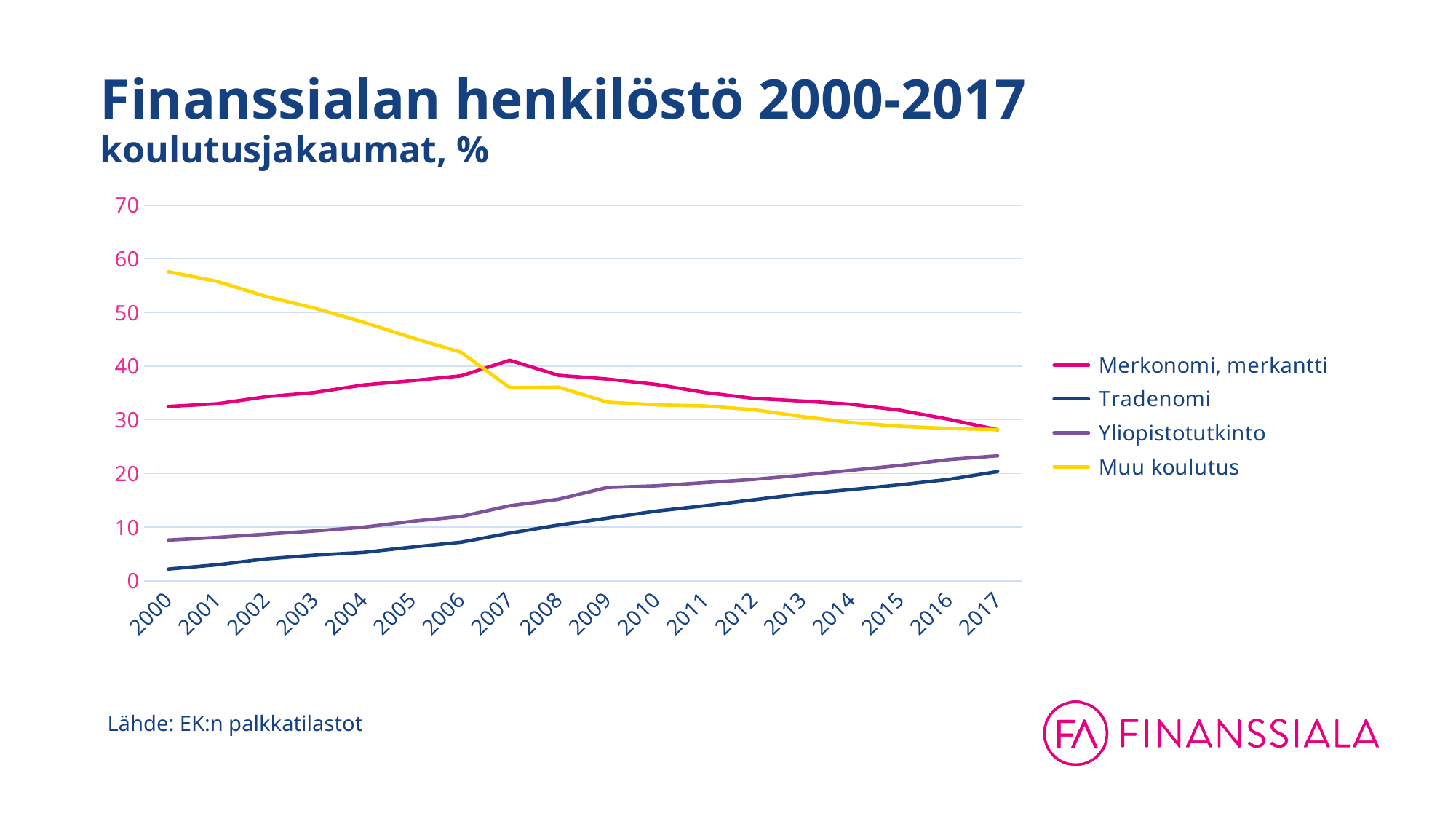
In 2010, which is larger: Merkonomi, merkantti or Muu koulutus? Merkonomi, merkantti What kind of chart is shown on the slide? line chart Does the Muu koulutus line rise or fall from 2000 to 2017? fall Is the value for Tradenomi in 2000 greater or less than 10? less How many years are shown on the x axis? 18 Is the value for Yliopistotutkinto in 2017 greater or less than 20? greater How many series does the legend list? 4 Which series has the lowest value in 2017? Tradenomi What colour is the Muu koulutus line? yellow Which series has the highest value in 2000? Muu koulutus Does the Tradenomi line rise or fall from 2000 to 2017? rise Is the value for Muu koulutus in 2000 greater or less than 50? greater